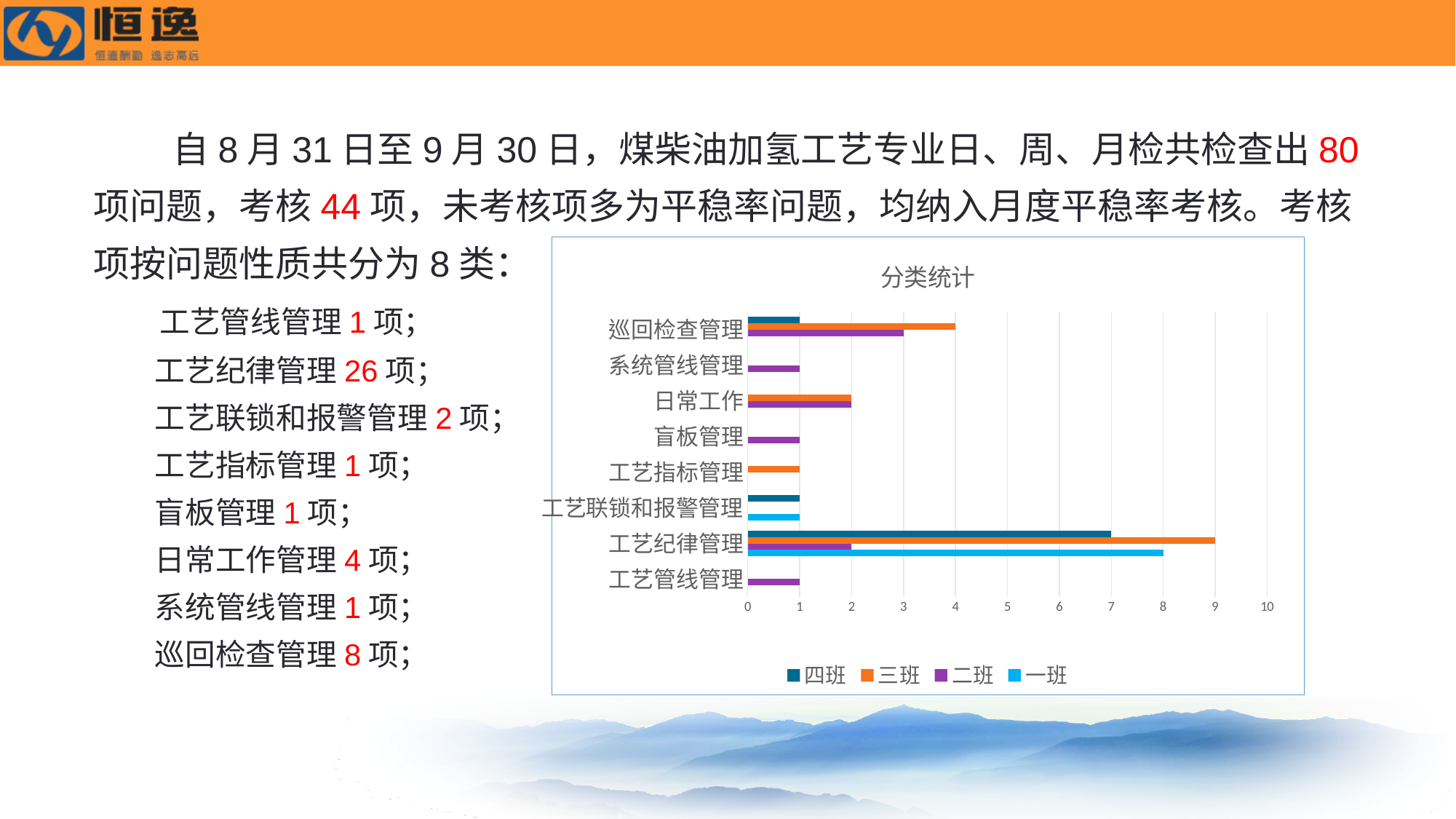
What is the value for 三班 in the 巡回检查管理 category? 4 What is the total of all four series in the 工艺纪律管理 category? 26 Which category has the highest value for 四班? 工艺纪律管理 In the 巡回检查管理 category, which is larger, the value for 三班 or the value for 二班? 三班 What is the title of the chart? 分类统计 What kind of chart is shown on the slide? bar chart What is the difference between the 三班 and 一班 values in the 工艺纪律管理 category? 1 What is the value for 三班 in the 工艺纪律管理 category? 9 What is the value for 一班 in the 工艺纪律管理 category? 8 How many series does the chart legend list? 4 How many categories are shown on the chart's vertical axis? 8 Is the value for 四班 in the 工艺纪律管理 category greater or less than 5? greater